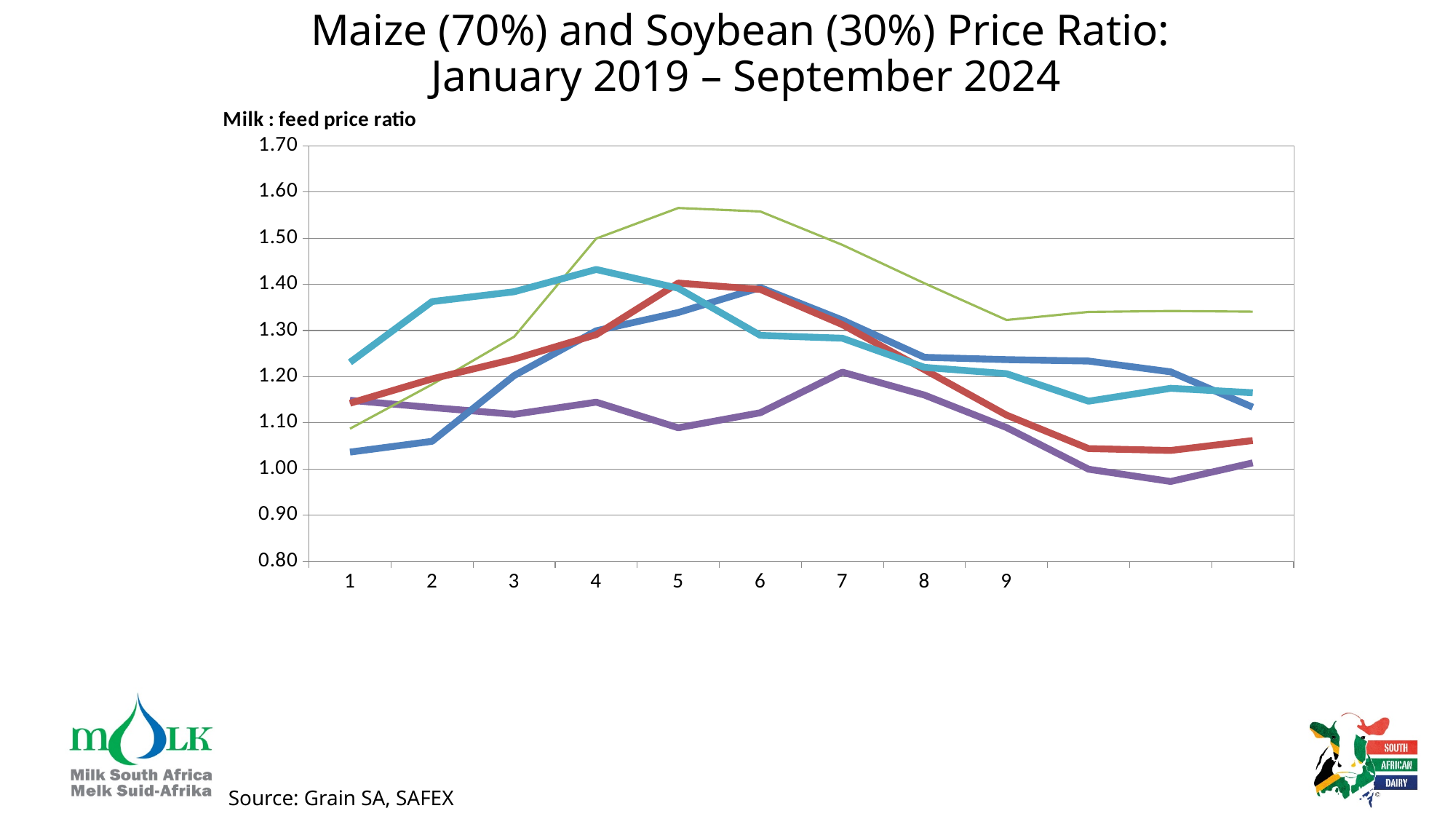
What label is shown above the vertical axis of the chart? Milk : feed price ratio Does the green line rise or fall between point 5 and point 9? fall Is the value of the light blue line at point 1 greater or less than 1.20? greater Is the value of the dark blue line at point 1 greater or less than 1.10? less Which line reaches the highest value on the chart? the green line How many lines are plotted on the chart? 5 Is the value of the green line at point 1 greater or less than 1.10? less What is the title of the chart? Maize (70%) and Soybean (30%) Price Ratio: January 2019 – September 2024 What kind of chart is shown on the slide? line chart Which line reaches the lowest value on the chart? the purple line